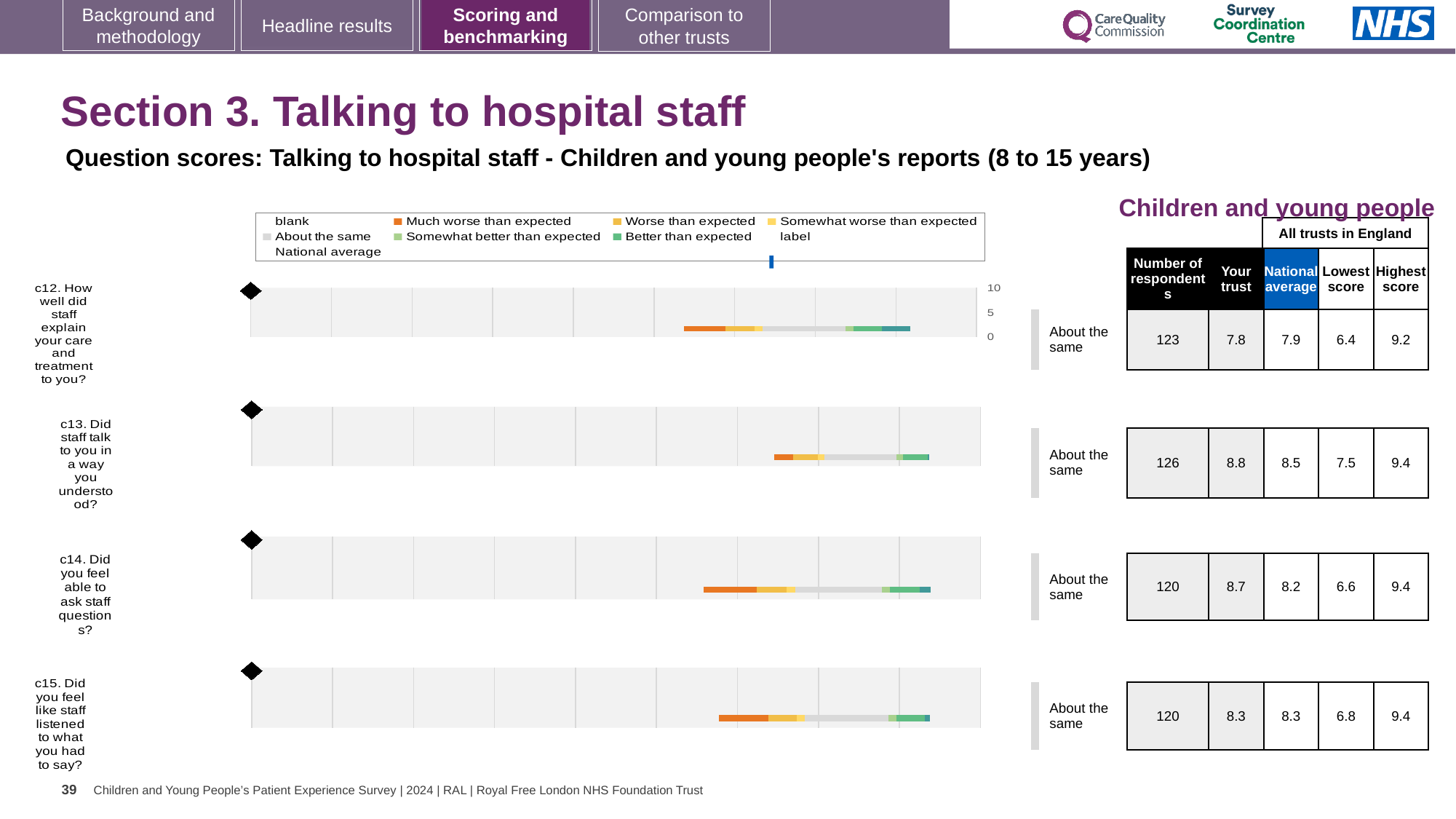
How many respondents answered c13? 126 For c12, which is larger: the 'Your trust' score or the national average? National average What kind of chart is used to show the question scores for c12 to c15? bar chart Which question has the lowest 'Your trust' score? c12 Which question has the highest 'Your trust' score? c13 How many questions (c12 to c15) are charted on the slide? 4 What is the 'Your trust' score for c13 (Did staff talk to you in a way you understood?)? 8.8 What benchmark category is shown for c14 (Did you feel able to ask staff questions?)? About the same What is the lowest score among all trusts in England for c13? 7.5 What is the national average score for c12 (How well did staff explain your care and treatment to you?)? 7.9 What is the highest score among all trusts in England for c12? 9.2 For c14, how much higher is the 'Your trust' score than the national average? 0.5